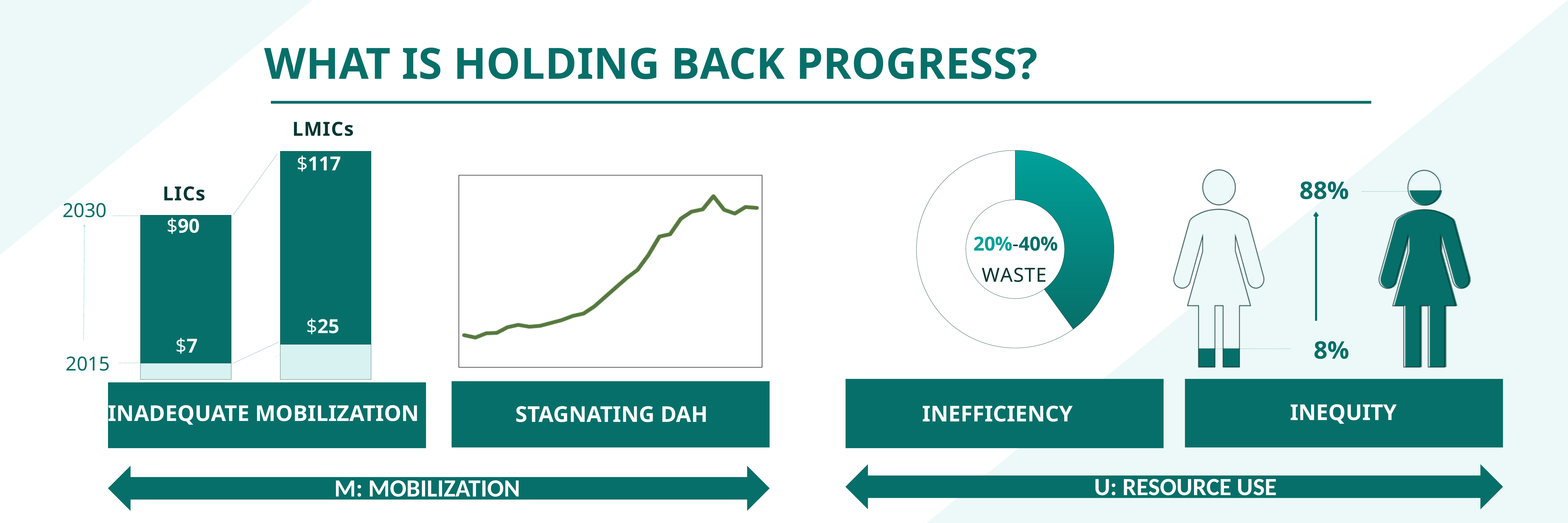
What kind of chart is shown under STAGNATING DAH? Line chart In the bar chart under INADEQUATE MOBILIZATION, which group has the higher 2030 value, LICs or LMICs? LMICs What range is printed in the centre of the donut chart under INEFFICIENCY? 20%-40% WASTE In the bar chart under INADEQUATE MOBILIZATION, what is the 2015 value for LICs? $7 In the bar chart under INADEQUATE MOBILIZATION, what is the 2030 value for LMICs? $117 In the INEQUITY graphic, what is the difference between the two percentages shown (88% and 8%)? 80% In the bar chart under INADEQUATE MOBILIZATION, what is the difference between the 2030 and 2015 values for LMICs? $92 In the chart under STAGNATING DAH, does the line generally rise or fall from left to right? Rise In the bar chart under INADEQUATE MOBILIZATION, what is the difference between the 2030 and 2015 values for LICs? $83 In the bar chart under INADEQUATE MOBILIZATION, what is the 2030 value for LICs? $90 In the bar chart under INADEQUATE MOBILIZATION, what is the 2015 value for LMICs? $25 In the bar chart under INADEQUATE MOBILIZATION, how many country groups are shown? 2